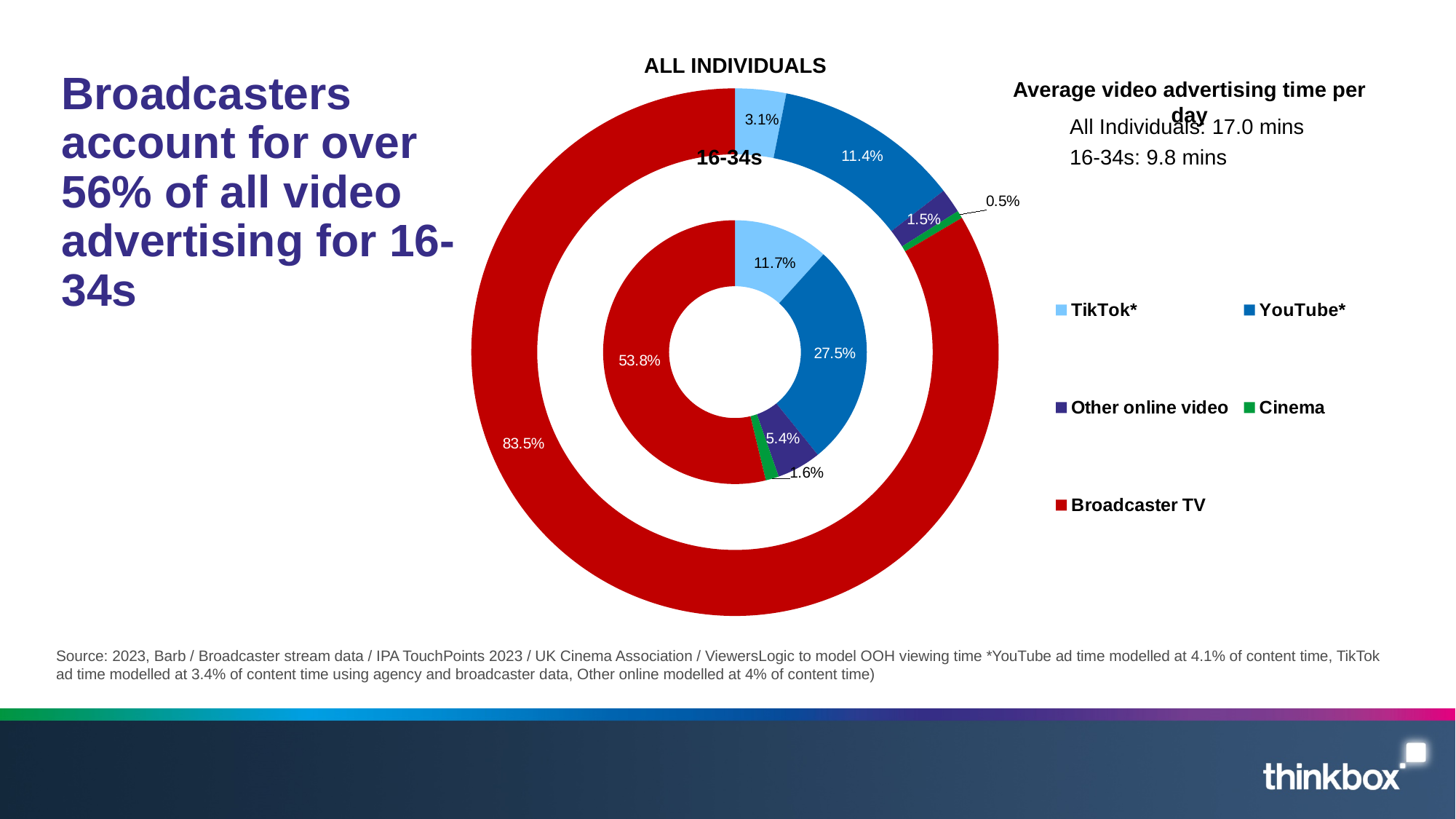
In the 16-34s ring, what share does Broadcaster TV account for? 53.8% Is the Other online video share larger for 16-34s or for ALL INDIVIDUALS? 16-34s In the ALL INDIVIDUALS ring, what is the value for TikTok*? 3.1% What is the difference between the TikTok* share for 16-34s and for ALL INDIVIDUALS? 8.6 percentage points How many categories does the legend list? 5 In the ALL INDIVIDUALS ring, what share does Broadcaster TV account for? 83.5% In the 16-34s ring, what is the value for YouTube*? 27.5% In the 16-34s ring, what is the value for Cinema? 1.6% What kind of chart is shown on the slide? Doughnut chart Which category has the largest share in the 16-34s ring? Broadcaster TV Which category has the smallest share in the ALL INDIVIDUALS ring? Cinema According to the text box, what is the average video advertising time per day for 16-34s? 9.8 mins